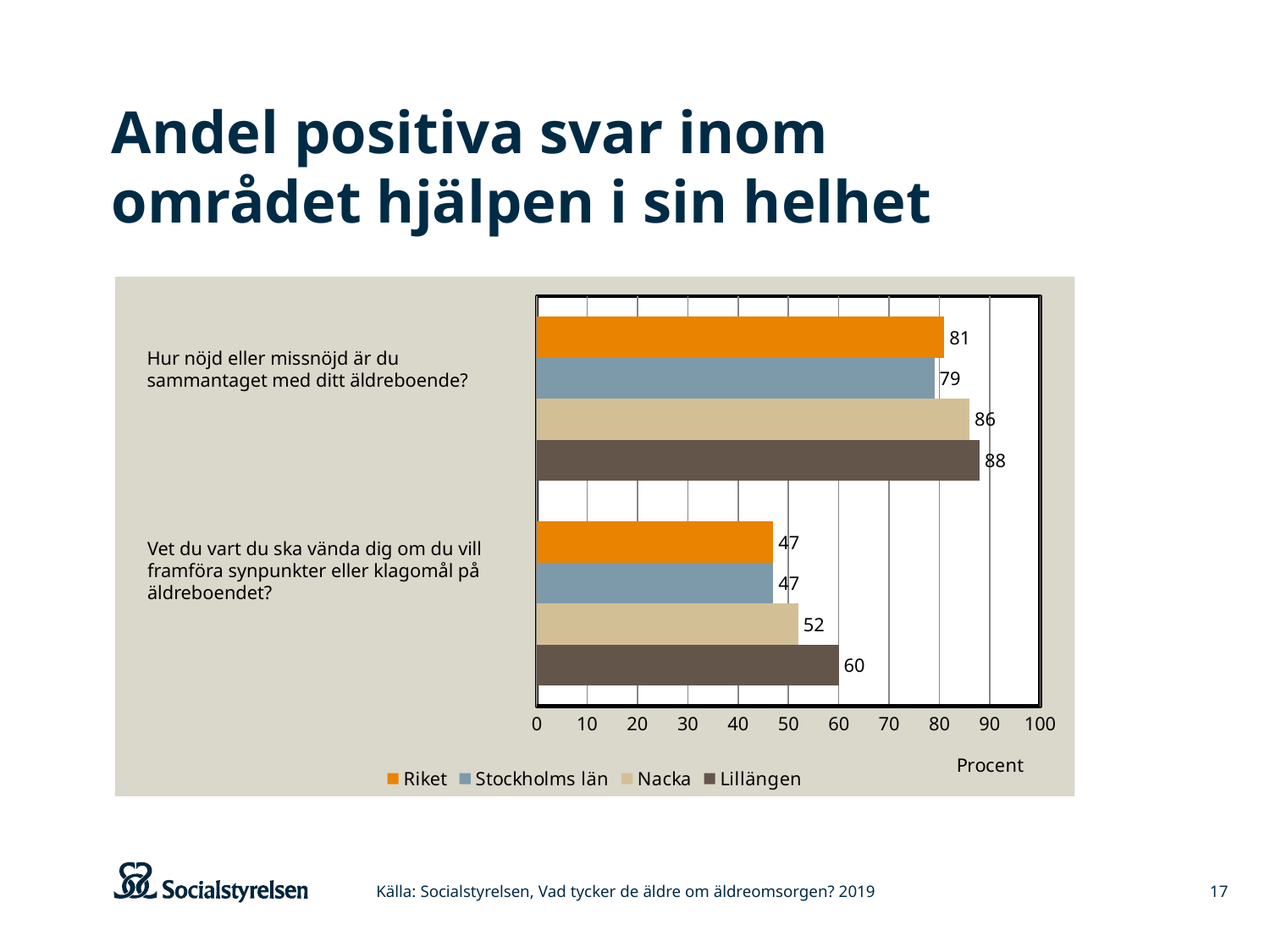
What value is shown for Nacka on the question "Vet du vart du ska vända dig om du vill framföra synpunkter eller klagomål på äldreboendet?"? 52 What is the difference between the Lillängen and Riket values for the question "Vet du vart du ska vända dig om du vill framföra synpunkter eller klagomål på äldreboendet?"? 13 What is the difference between the Nacka and Stockholms län values for the question "Hur nöjd eller missnöjd är du sammantaget med ditt äldreboende?"? 7 What value is shown for Riket on the question "Vet du vart du ska vända dig om du vill framföra synpunkter eller klagomål på äldreboendet?"? 47 What value is shown for Stockholms län on the question "Hur nöjd eller missnöjd är du sammantaget med ditt äldreboende?"? 79 What value is shown for Lillängen on the question "Hur nöjd eller missnöjd är du sammantaget med ditt äldreboende?"? 88 What kind of chart is shown on the slide? Bar chart What unit is labelled on the horizontal axis of the chart? Procent Which series has the highest value for the question "Hur nöjd eller missnöjd är du sammantaget med ditt äldreboende?"? Lillängen Which series has the lowest value for the question "Hur nöjd eller missnöjd är du sammantaget med ditt äldreboende?"? Stockholms län How many series does the legend list? 4 For the question "Vet du vart du ska vända dig om du vill framföra synpunkter eller klagomål på äldreboendet?", which is larger: the value for Nacka or the value for Lillängen? Lillängen